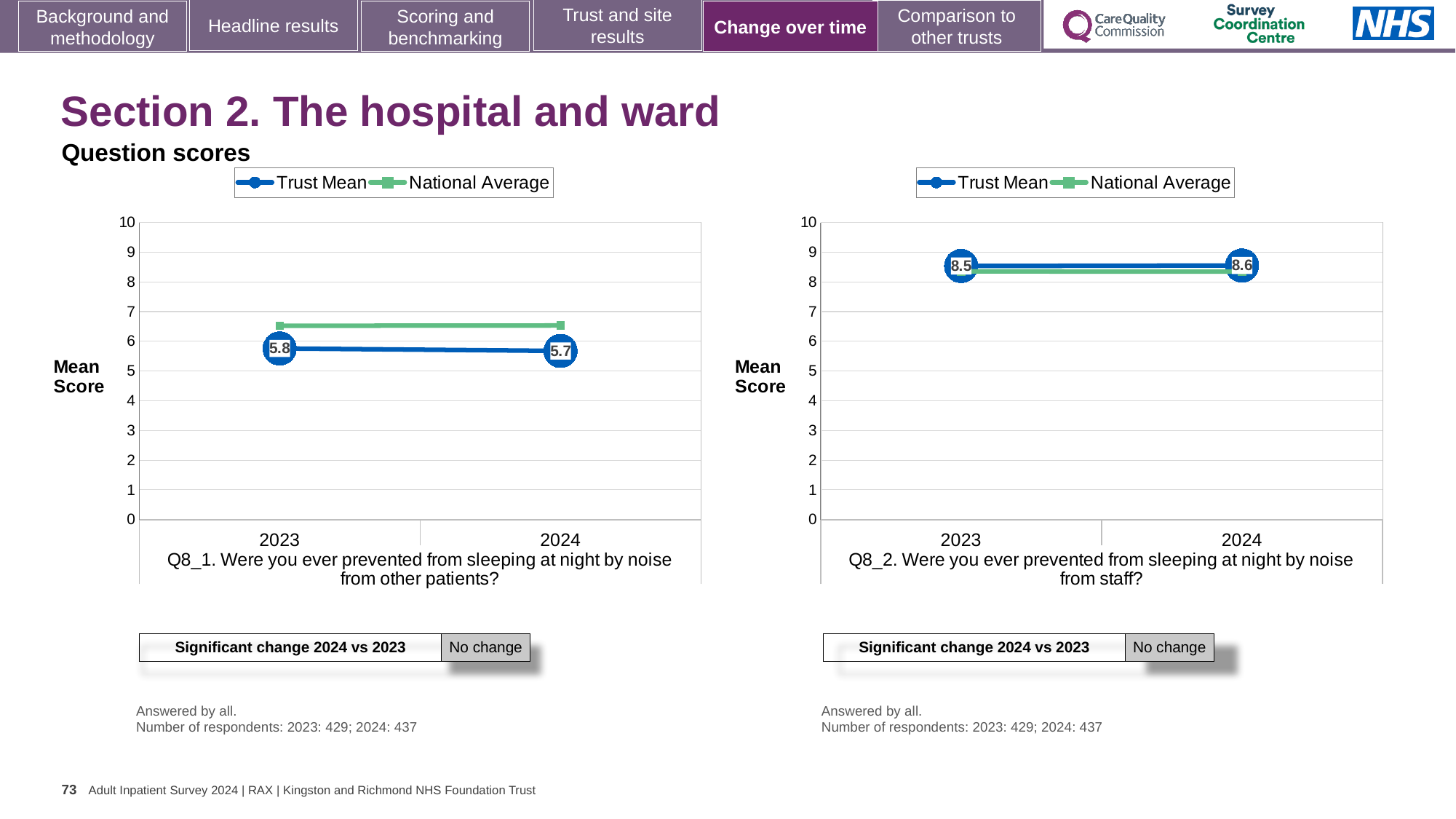
In the Q8_2 chart (right), what is the Trust Mean for 2024? 8.6 In the Q8_1 chart (left), what is the Trust Mean for 2023? 5.8 How many years are plotted on the x axis of the Q8_2 chart (right)? 2 How many series does the legend of the Q8_2 chart (right) list? 2 In the Q8_1 chart (left), is the National Average for 2024 greater or less than 6? greater What kind of chart is the Q8_1 chart (left)? line chart In the Q8_2 chart (right), what is the Trust Mean for 2023? 8.5 In the Q8_1 chart (left), does the Trust Mean rise or fall from 2023 to 2024? fall In the Q8_2 chart (right), does the Trust Mean rise or fall from 2023 to 2024? rise In the Q8_1 chart (left), what is the Trust Mean for 2024? 5.7 In the Q8_1 chart (left), which is higher in 2023, the Trust Mean or the National Average? National Average In the Q8_1 chart (left), what is the difference between the Trust Mean for 2023 and 2024? 0.1